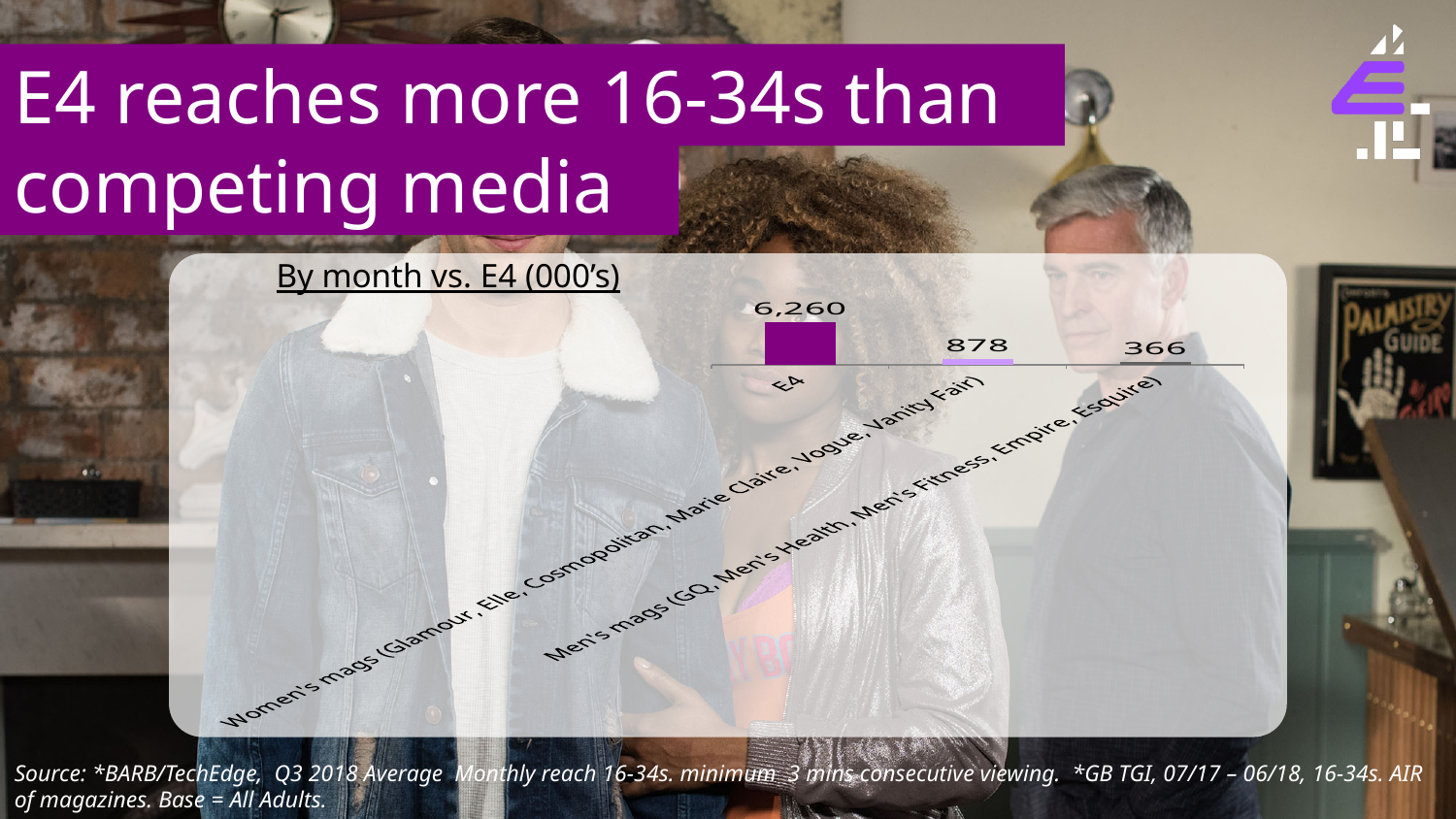
What is the value for E4? 6,260 What is the value for Men's mags (GQ, Men's Health, Men's Fitness, Empire, Esquire)? 366 What is the difference between the value for E4 and the value for Women's mags? 5,382 Do the values rise or fall from left to right across the categories? Fall What is the value for Women's mags (Glamour, Elle, Cosmopolitan, Marie Claire, Vogue, Vanity Fair)? 878 Which category has the lowest value? Men's mags (GQ, Men's Health, Men's Fitness, Empire, Esquire) What is the title of the chart? By month vs. E4 (000's) What kind of chart is shown on the slide? Bar chart Which is larger, the value for Women's mags or the value for Men's mags? Women's mags Which category has the highest value? E4 How many categories are shown in the chart? 3 What is the difference between the value for Women's mags and the value for Men's mags? 512